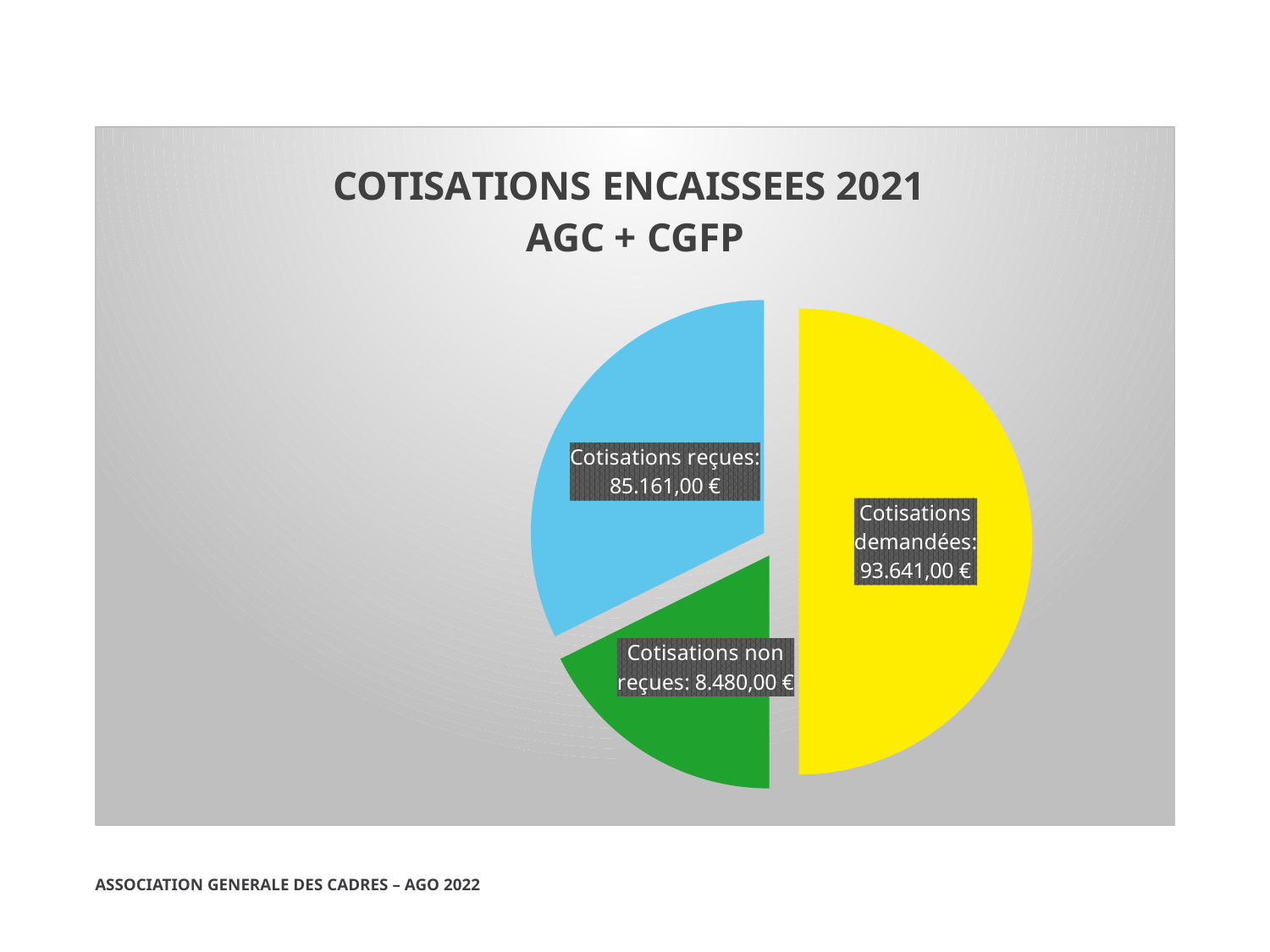
What kind of chart is shown on the slide? Pie chart What is the value shown for Cotisations demandées? 93.641,00 € Which slice of the pie chart is the largest? Cotisations demandées What is the difference between Cotisations demandées and Cotisations reçues? 8.480,00 € What is the value shown for Cotisations non reçues? 8.480,00 € What is the value shown for Cotisations reçues? 85.161,00 € What colour is the Cotisations demandées slice? Yellow What is the difference between Cotisations reçues and Cotisations non reçues? 76.681,00 € How many slices does the pie chart have? 3 What is the title of the chart? COTISATIONS ENCAISSEES 2021 AGC + CGFP Which is larger, Cotisations reçues or Cotisations non reçues? Cotisations reçues Which slice of the pie chart is the smallest? Cotisations non reçues